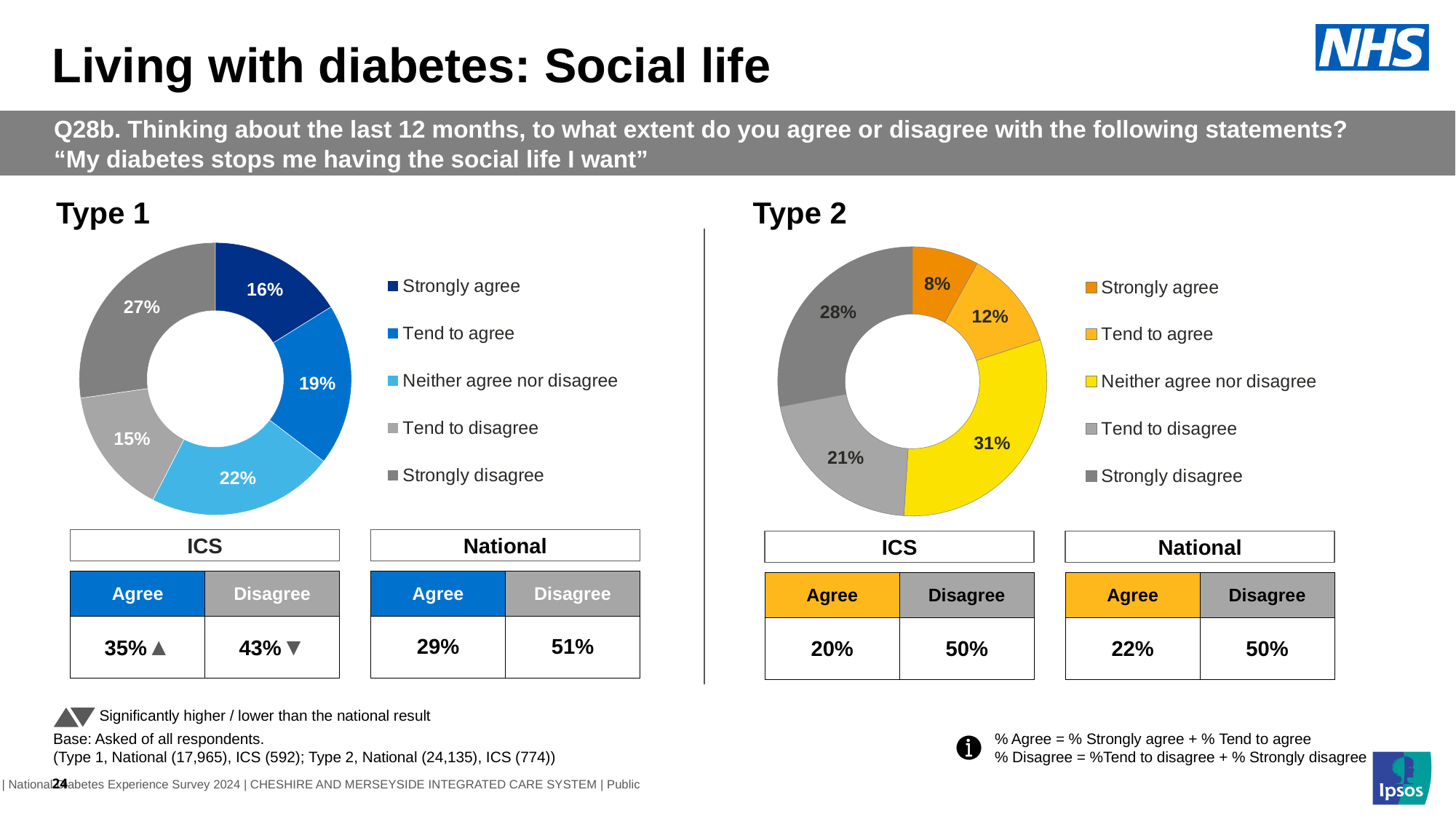
In the Type 2 chart, what percentage of respondents said they neither agree nor disagree? 31% In the Type 1 chart, what is the difference in percentage points between Strongly disagree and Strongly agree? 11 In the Type 2 chart, which is larger: Tend to disagree or Tend to agree? Tend to disagree In the Type 2 chart, what percentage of respondents said they strongly agree? 8% In the Type 1 chart, what colour is the Neither agree nor disagree segment? Light blue In the Type 1 chart, which response category has the largest share? Strongly disagree In the Type 2 chart, which response category has the smallest share? Strongly agree In the Type 2 chart, what is the combined share of Strongly agree and Tend to agree? 20% What kind of chart is used for the Type 1 results? Donut chart In the Type 1 chart, what percentage of respondents said they tend to disagree? 15% In the Type 1 chart, what percentage of respondents said they strongly agree? 16% How many response categories does the Type 2 chart's legend list? 5